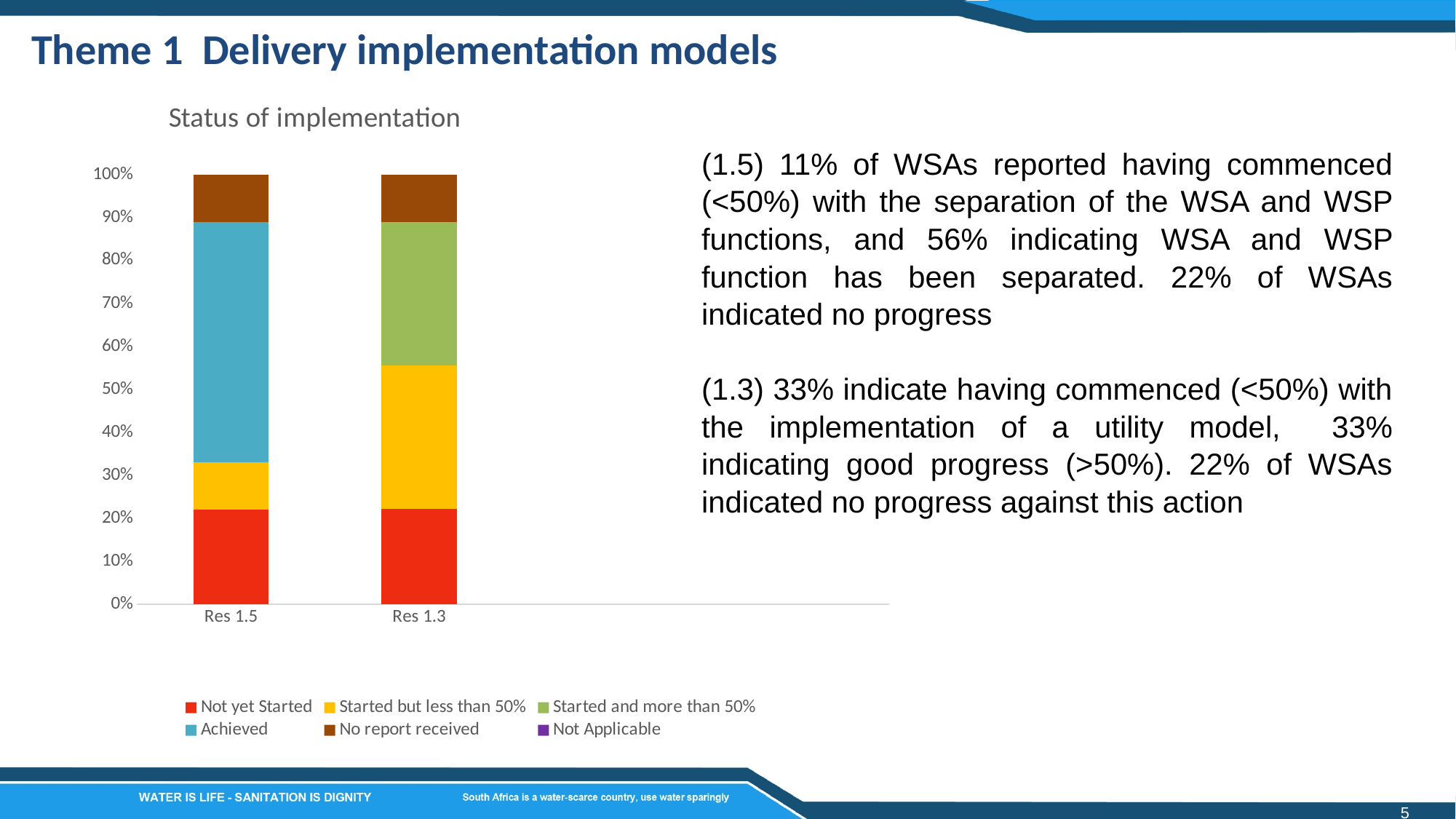
How many series does the chart legend list? 6 What type of chart is shown on the slide? Stacked bar chart Is the No report received segment for Res 1.3 greater or less than 20%? less Which legend series does not appear in either bar of the chart? Not Applicable What is the title of the chart? Status of implementation Is the Started but less than 50% segment for Res 1.3 greater or less than 20%? greater How many categories are shown on the x axis of the chart? 2 What is the total height of the Res 1.5 stacked bar? 100% Which category has the larger Started but less than 50% segment, Res 1.5 or Res 1.3? Res 1.3 Is the Not yet Started segment for Res 1.5 greater or less than 30%? less Which category has the larger Achieved segment, Res 1.5 or Res 1.3? Res 1.5